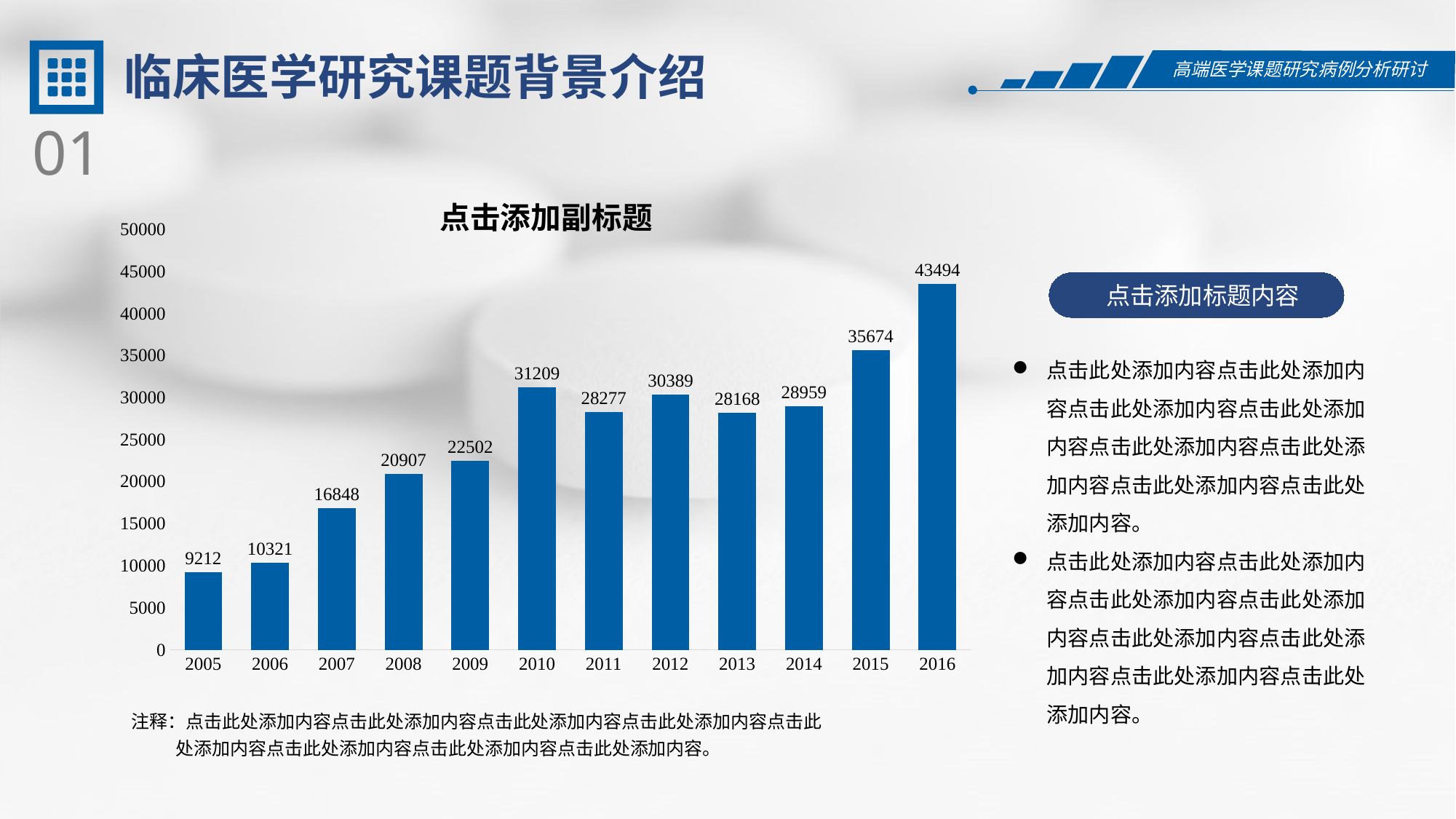
Which year has the lowest value? 2005 What is the title of the chart? 点击添加副标题 How many years are shown on the x axis? 12 What is the value for 2005? 9212 Is the value for 2009 greater or less than 25000? less What is the value for 2013? 28168 Which year has the highest value? 2016 What is the difference between the values for 2016 and 2015? 7820 What is the difference between the values for 2007 and 2006? 6527 What kind of chart is shown on the slide? bar chart Which is larger, the value for 2010 or the value for 2012? 2010 What is the value for 2010? 31209